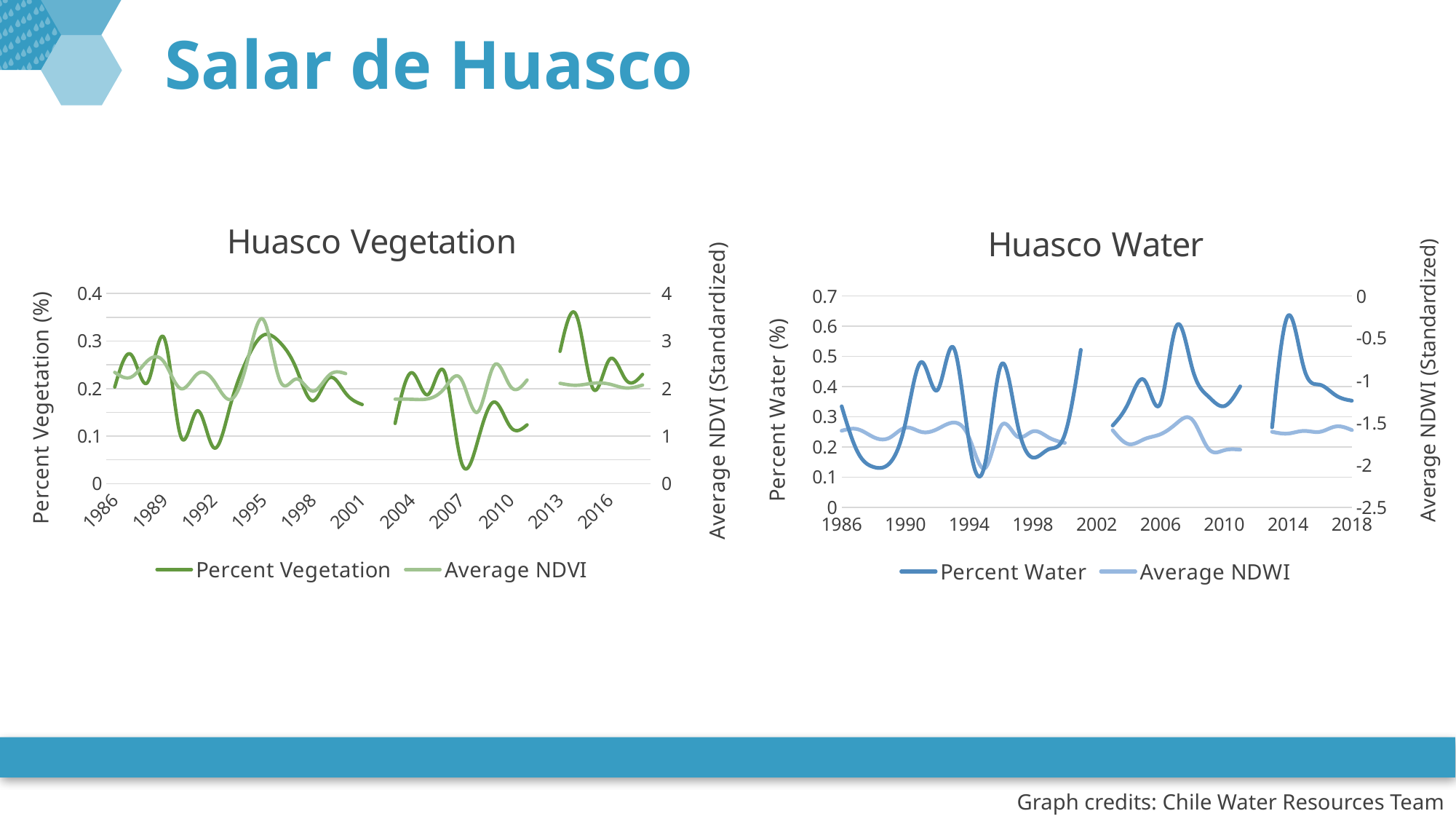
In the Huasco Water chart, what is the label of the right-hand vertical axis? Average NDWI (Standardized) How many series does the legend of the Huasco Water chart list? 2 In the Huasco Water chart, is the Average NDWI value around 2010 greater or less than -1.5? less What kind of chart is the Huasco Vegetation chart? line chart How many series does the legend of the Huasco Vegetation chart list? 2 In the Huasco Vegetation chart, is the lowest value of Percent Vegetation around 2008 greater or less than 0.1? less In the Huasco Water chart, is the peak value of Percent Water around 2014 greater or less than 0.6? greater In the Huasco Vegetation chart, what are the two series named in the legend? Percent Vegetation and Average NDVI What kind of chart is the Huasco Water chart? line chart